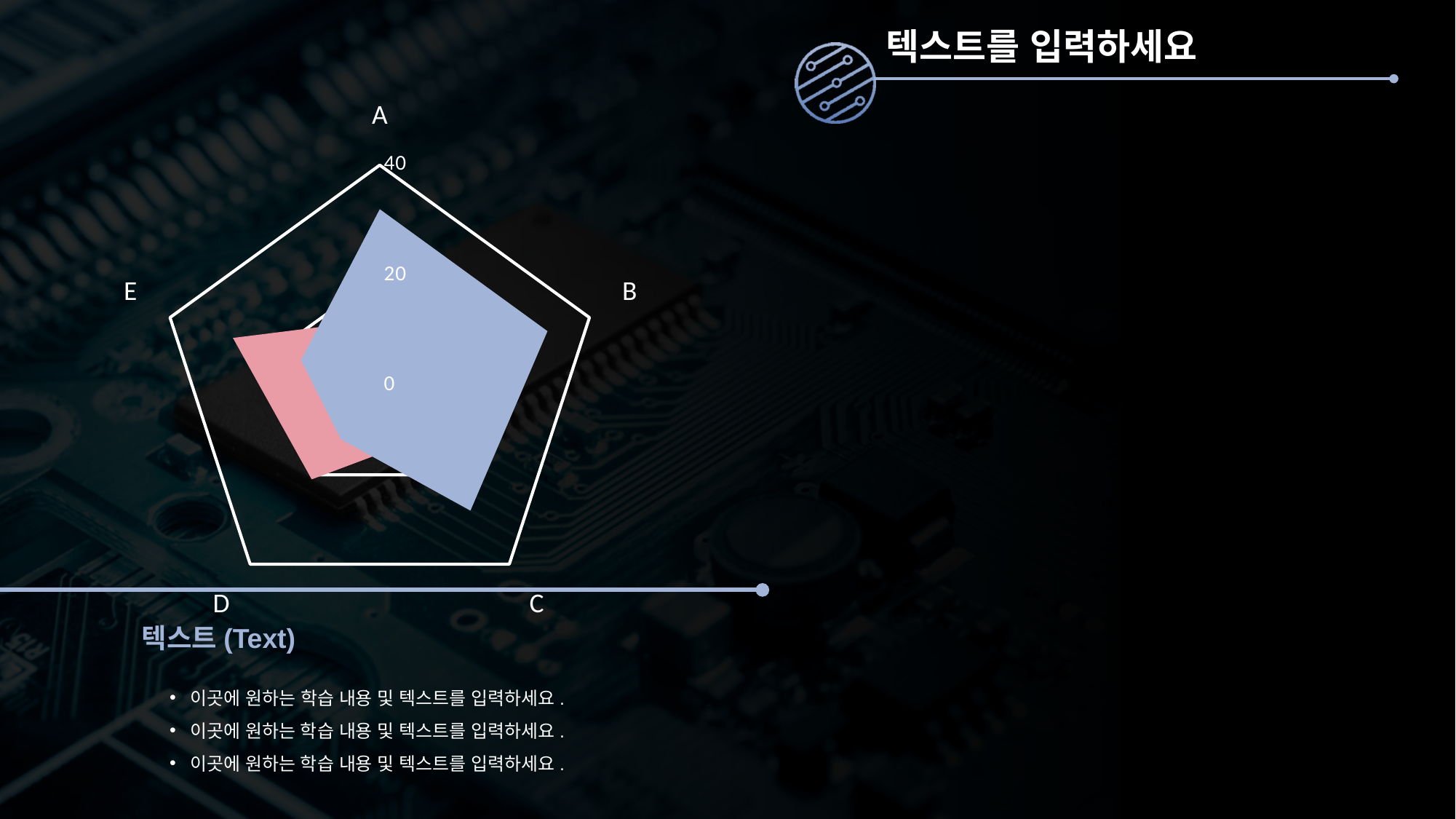
What is the maximum value shown on the radar chart's axis scale? 40 For category E, which series has the larger value, the blue or the pink? pink What kind of chart is shown on the slide? radar chart How many data series are plotted on the radar chart? 2 What are the category labels around the radar chart? A, B, C, D, E Is the blue series value for A greater or less than 20? greater For category B, which series has the larger value, the blue or the pink? blue How many categories (axes) does the radar chart have? 5 Is the blue series value for B greater or less than 20? greater Is the pink series value for E greater or less than 20? greater